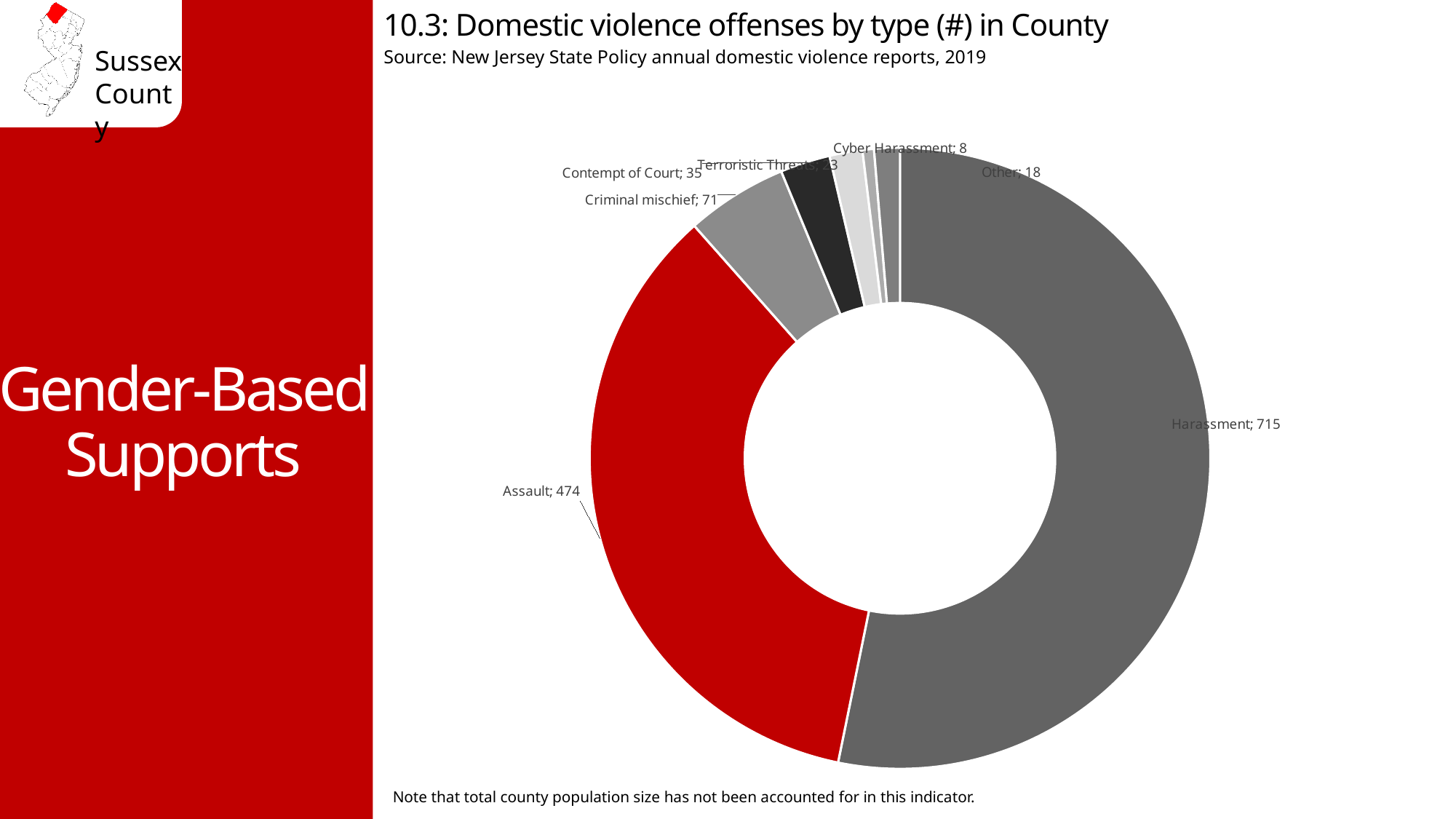
What is the value shown for Cyber Harassment? 8 What type of chart is shown on the slide? Pie (doughnut) chart Which offense type has the largest number of offenses? Harassment How many offense categories are shown in the chart? 7 What is the value shown for Contempt of Court? 35 How many domestic violence offenses of type Harassment are shown? 715 What is the value shown for Criminal mischief? 71 Which is larger, Criminal mischief or Contempt of Court? Criminal mischief What is the value shown for the Other category? 18 What is the value shown for Assault? 474 Which offense type has the smallest number of offenses? Cyber Harassment What is the difference between the Harassment and Assault values? 241